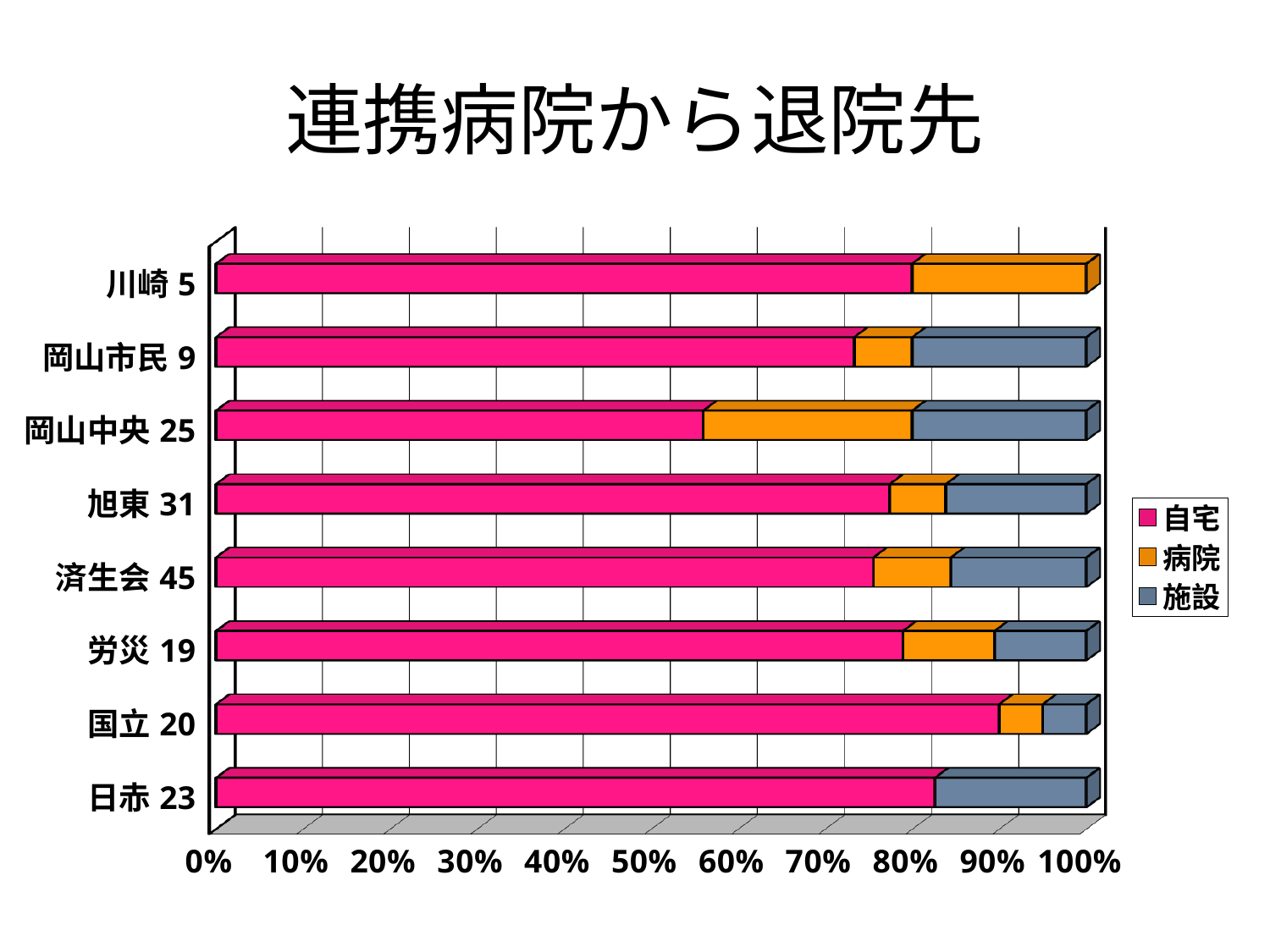
Is the 自宅 share for 岡山中央 25 greater or less than 60%? less What is the title of the chart? 連携病院から退院先 Is the 自宅 share for 川崎 5 greater or less than 70%? greater How many hospital categories are plotted on the chart? 8 What are the three legend entries of the chart? 自宅, 病院, 施設 Which hospital has the lowest share of 自宅? 岡山中央 25 Which has a larger 病院 share, 川崎 5 or 国立 20? 川崎 5 What kind of chart is shown on the slide? Stacked bar chart Which has a larger 自宅 share, 国立 20 or 岡山中央 25? 国立 20 How many series does the legend list? 3 Is the 自宅 share for 国立 20 greater or less than 80%? greater Which hospital has the highest share of 自宅? 国立 20